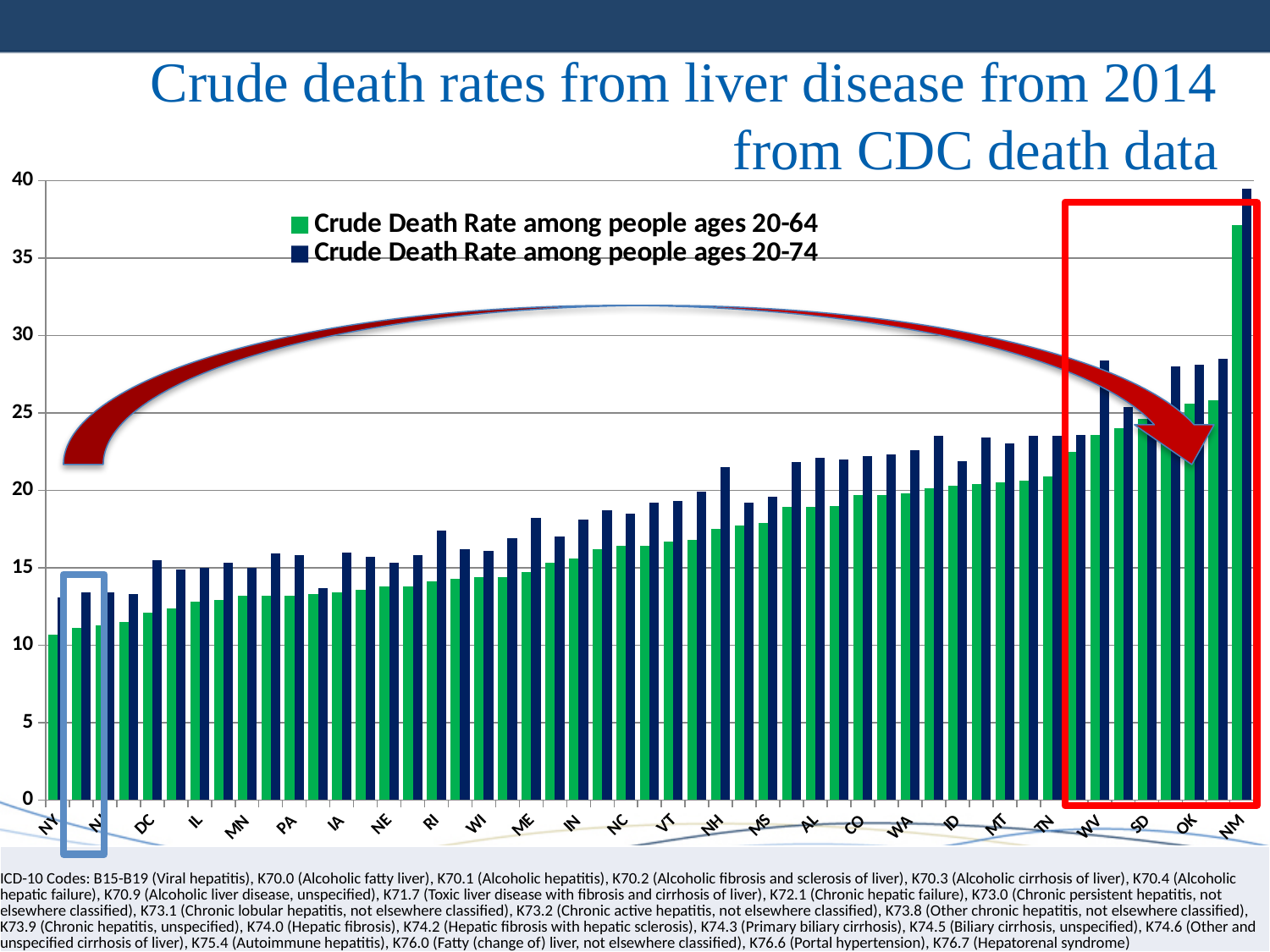
Which state has the highest crude death rate among people ages 20-74? NM What kind of chart is shown on the slide? bar chart Do the crude death rates generally rise or fall moving from left to right along the x axis? rise Is the crude death rate among people ages 20-64 for NY greater or less than 15? less Which state has the lowest crude death rate among people ages 20-64? NY What is the title of the chart? Crude death rates from liver disease from 2014 from CDC death data Which is larger for NM: the crude death rate among people ages 20-64 or among people ages 20-74? ages 20-74 Is the crude death rate among people ages 20-74 for OK greater or less than 25? greater How many series does the legend list? 2 Is the crude death rate among people ages 20-64 for DC greater or less than 15? less What are the two series named in the legend? Crude Death Rate among people ages 20-64; Crude Death Rate among people ages 20-74